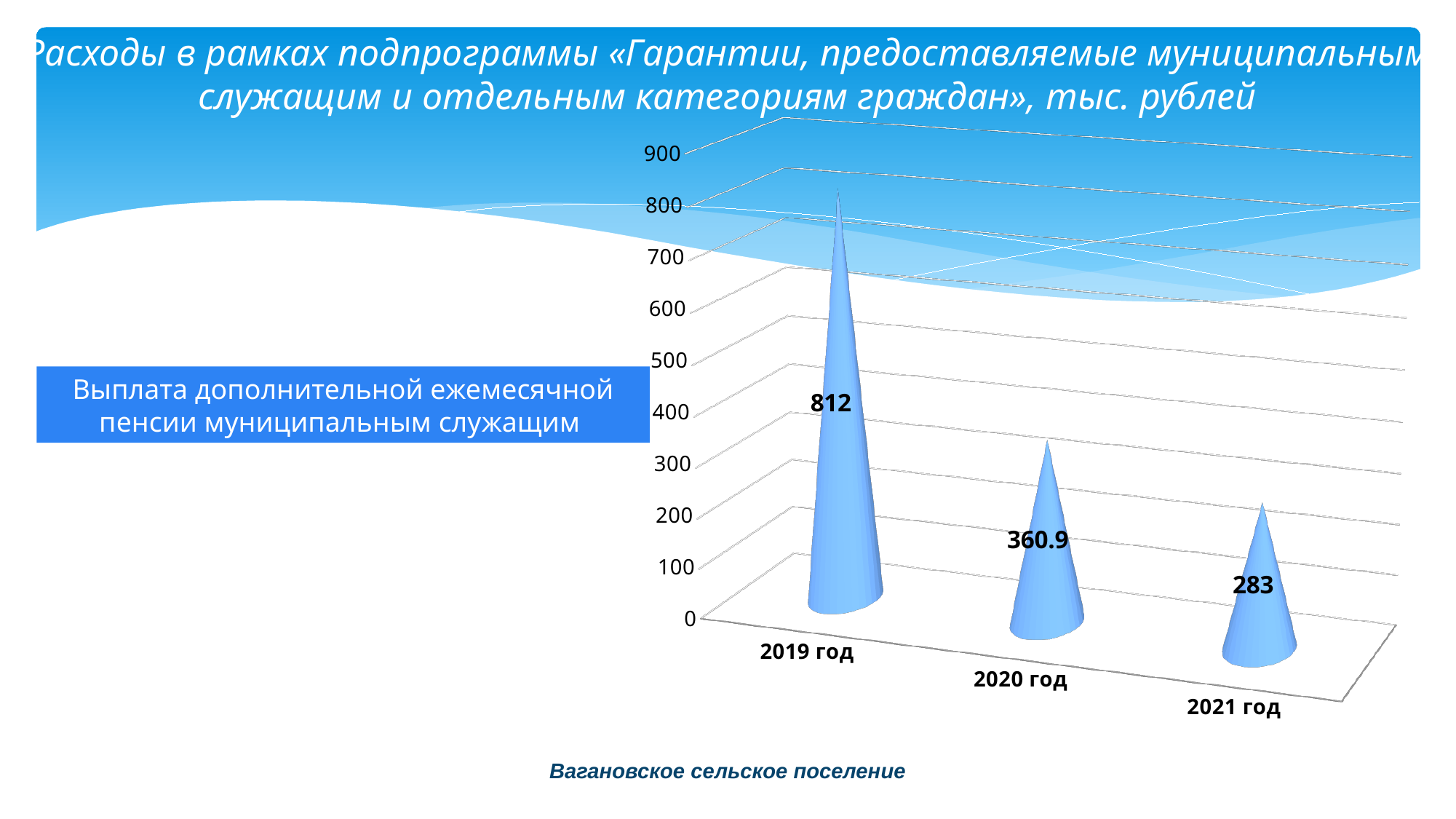
What is the difference between the values for 2019 год and 2020 год? 451.1 Which year has the lowest value? 2021 год What is the value for 2020 год? 360.9 Which year has the highest value? 2019 год What unit of measurement is stated in the chart title? тыс. рублей What is the value for 2019 год? 812 Which is larger, the value for 2020 год or the value for 2021 год? 2020 год How many years are shown on the chart? 3 What is the difference between the values for 2020 год and 2021 год? 77.9 Is the value for 2019 год greater or less than 800? greater Do the values rise or fall from 2019 год to 2021 год? fall What is the value for 2021 год? 283